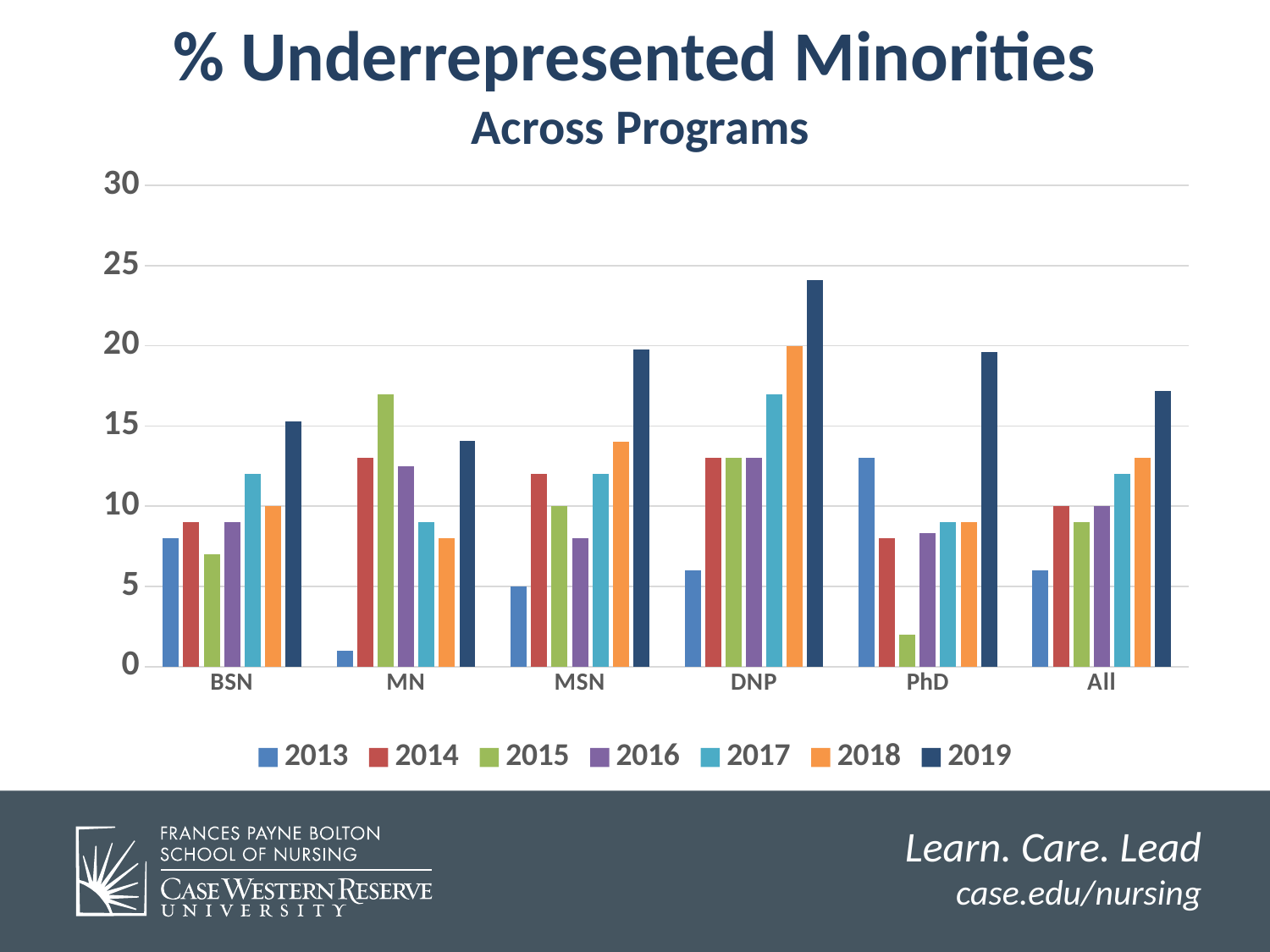
Is the 2019 value for DNP greater or less than 20? greater What is the subtitle of the chart? Across Programs What kind of chart is shown on the slide? bar chart How many series does the legend list? 7 Which program has the lowest 2013 value? MN Is the 2015 value for PhD greater or less than 5? less Is the 2015 value for MN greater or less than 15? greater Which is larger for PhD, the 2013 value or the 2014 value? 2013 Which is larger for MSN, the 2018 value or the 2019 value? 2019 How many program categories are shown on the x axis? 6 Which program has the highest 2019 value? DNP